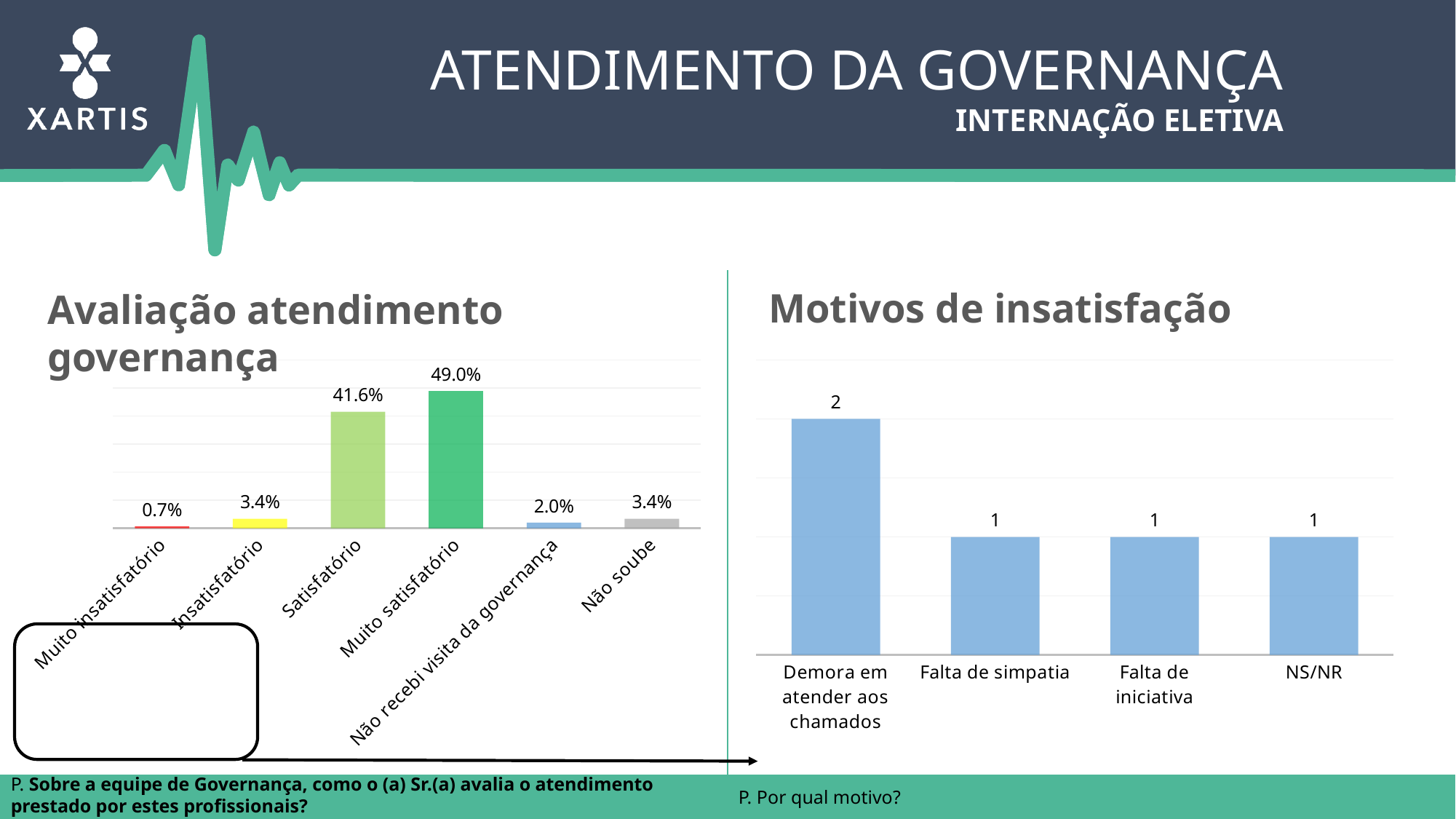
In the 'Avaliação atendimento governança' chart, what is the difference between Muito satisfatório and Satisfatório? 7.4% How many categories are shown in the 'Motivos de insatisfação' chart? 4 In the 'Avaliação atendimento governança' chart, which category has the lowest value? Muito insatisfatório In the 'Avaliação atendimento governança' chart, which is larger: Insatisfatório or Não recebi visita da governança? Insatisfatório In the 'Motivos de insatisfação' chart, which category has the highest value? Demora em atender aos chamados In the 'Avaliação atendimento governança' chart, what is the value for Muito satisfatório? 49.0% In the 'Avaliação atendimento governança' chart, what is the value for Não recebi visita da governança? 2.0% What type of chart is the 'Motivos de insatisfação' chart? Bar chart In the 'Motivos de insatisfação' chart, what is the value for Demora em atender aos chamados? 2 How many categories are shown in the 'Avaliação atendimento governança' chart? 6 In the 'Avaliação atendimento governança' chart, what is the value for Satisfatório? 41.6% In the 'Avaliação atendimento governança' chart, which category has the highest value? Muito satisfatório